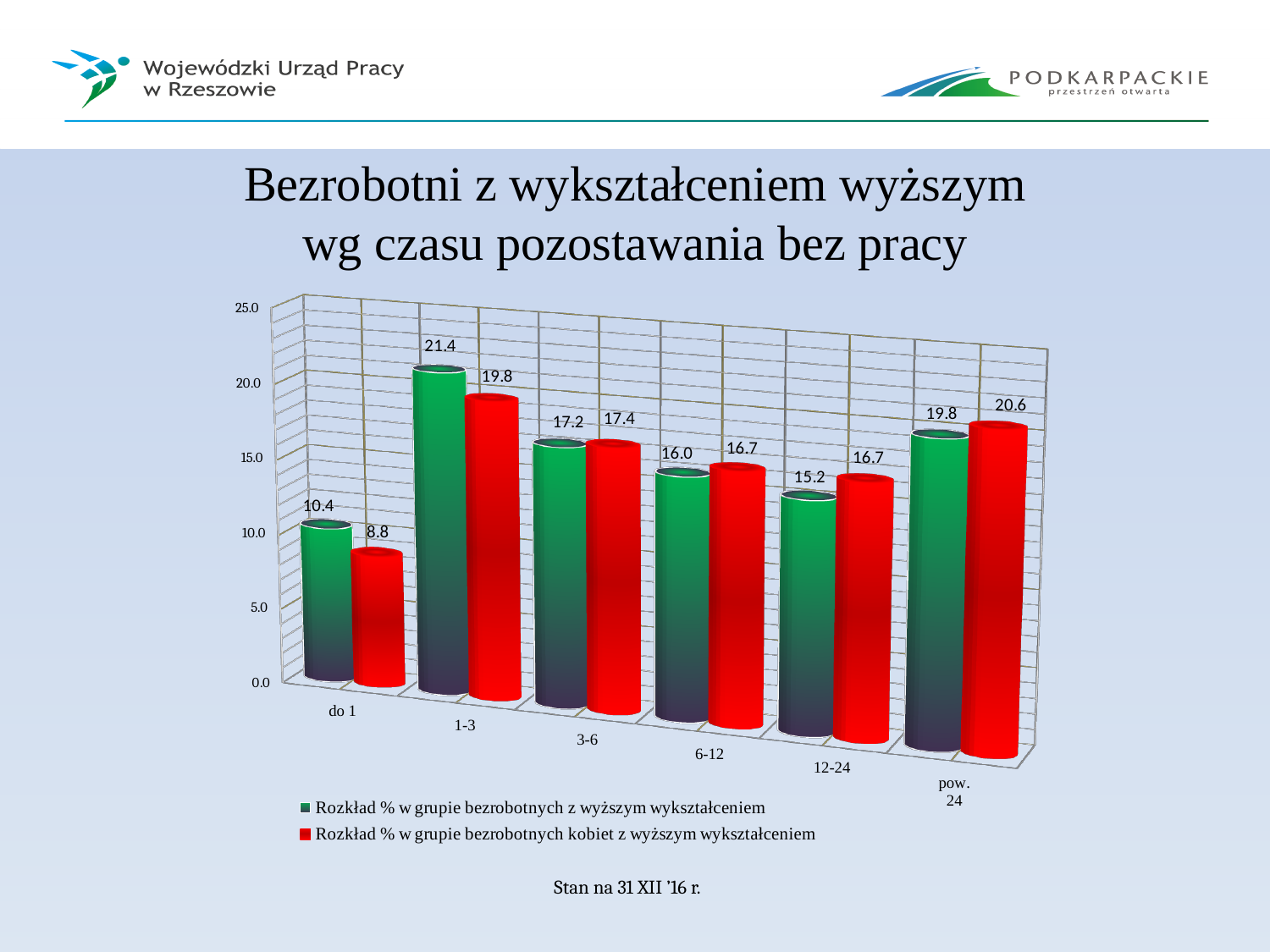
What is the value for the '1-3' category in the series 'Rozkład % w grupie bezrobotnych z wyższym wykształceniem'? 21.4 What is the value for the 'pow. 24' category in the series 'Rozkład % w grupie bezrobotnych kobiet z wyższym wykształceniem'? 20.6 How many categories are shown on the x axis? 6 What is the difference between the two series' values for the 'do 1' category? 1.6 Is the value for '6-12' in the series 'Rozkład % w grupie bezrobotnych z wyższym wykształceniem' greater or less than 20.0? less Which category has the highest value in the series 'Rozkład % w grupie bezrobotnych z wyższym wykształceniem'? 1-3 For the '12-24' category, which series has the larger value? Rozkład % w grupie bezrobotnych kobiet z wyższym wykształceniem Which category has the lowest value in the series 'Rozkład % w grupie bezrobotnych kobiet z wyższym wykształceniem'? do 1 What date is given below the chart as the reference date ('Stan na')? 31 XII '16 r. What is the value for the 'do 1' category in the series 'Rozkład % w grupie bezrobotnych kobiet z wyższym wykształceniem'? 8.8 How many series does the legend list? 2 What kind of chart is shown on the slide? bar chart